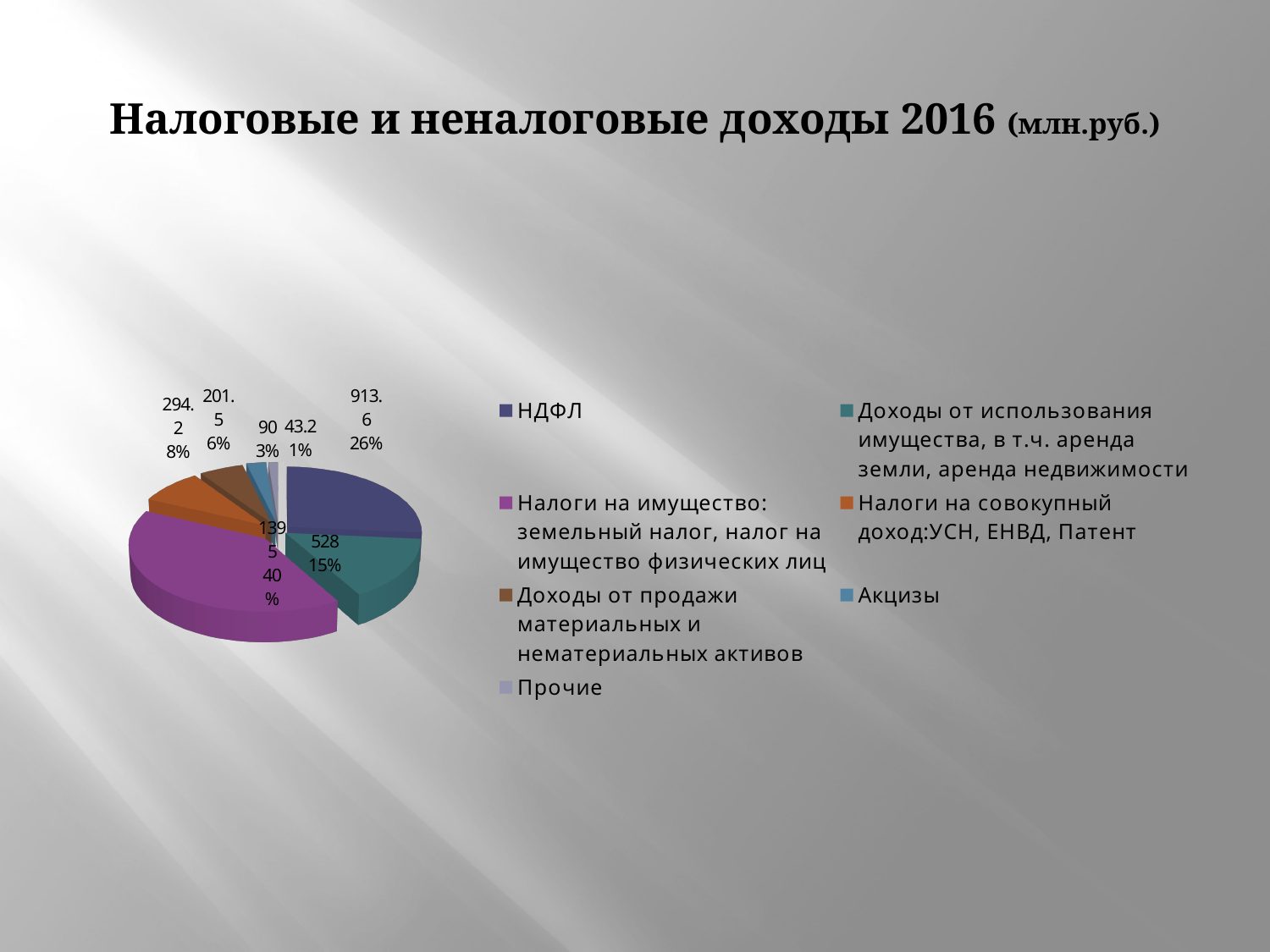
What is the difference between the value for НДФЛ and the value for Доходы от использования имущества? 385.6 What type of chart is shown on the slide? Pie chart What is the title of the slide's chart? Налоговые и неналоговые доходы 2016 (млн.руб.) How many categories are shown in the pie chart? 7 What is the value shown for Доходы от использования имущества, в т.ч. аренда земли, аренда недвижимости? 528 What share of the pie does Прочие represent? 1% Which is larger: Налоги на совокупный доход:УСН, ЕНВД, Патент or Доходы от продажи материальных и нематериальных активов? Налоги на совокупный доход:УСН, ЕНВД, Патент What is the value shown for Акцизы? 90 Which category has the smallest slice of the pie? Прочие What share of the pie does НДФЛ represent? 26% Which category has the largest slice of the pie? Налоги на имущество: земельный налог, налог на имущество физических лиц What is the value shown for НДФЛ? 913.6